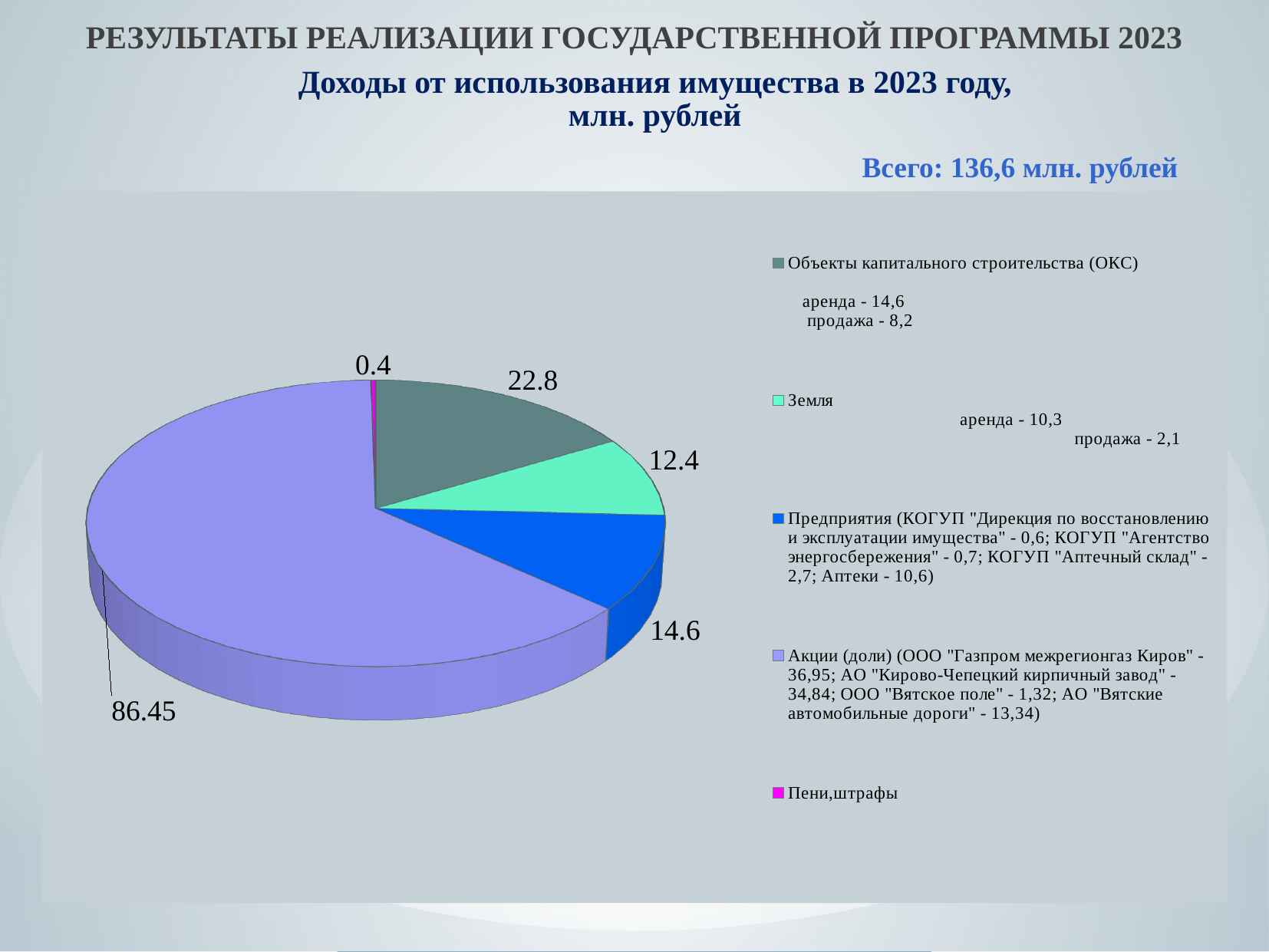
Which category has the largest slice in the pie chart? Акции (доли) What total amount in million rubles is stated on the slide? 136,6 млн. рублей What is the value of the Акции (доли) slice in the pie chart? 86.45 How many slices does the pie chart have? 5 What type of chart is shown on the slide? Pie chart What is the value of the Пени,штрафы slice? 0.4 What is the difference between the Акции (доли) value and the ОКС value? 63.65 What is the value of the Предприятия slice? 14.6 What is the value of the Объекты капитального строительства (ОКС) slice? 22.8 Which category has the smallest slice in the pie chart? Пени,штрафы What is the value of the Земля slice? 12.4 Which is larger, the Предприятия slice or the Земля slice? Предприятия